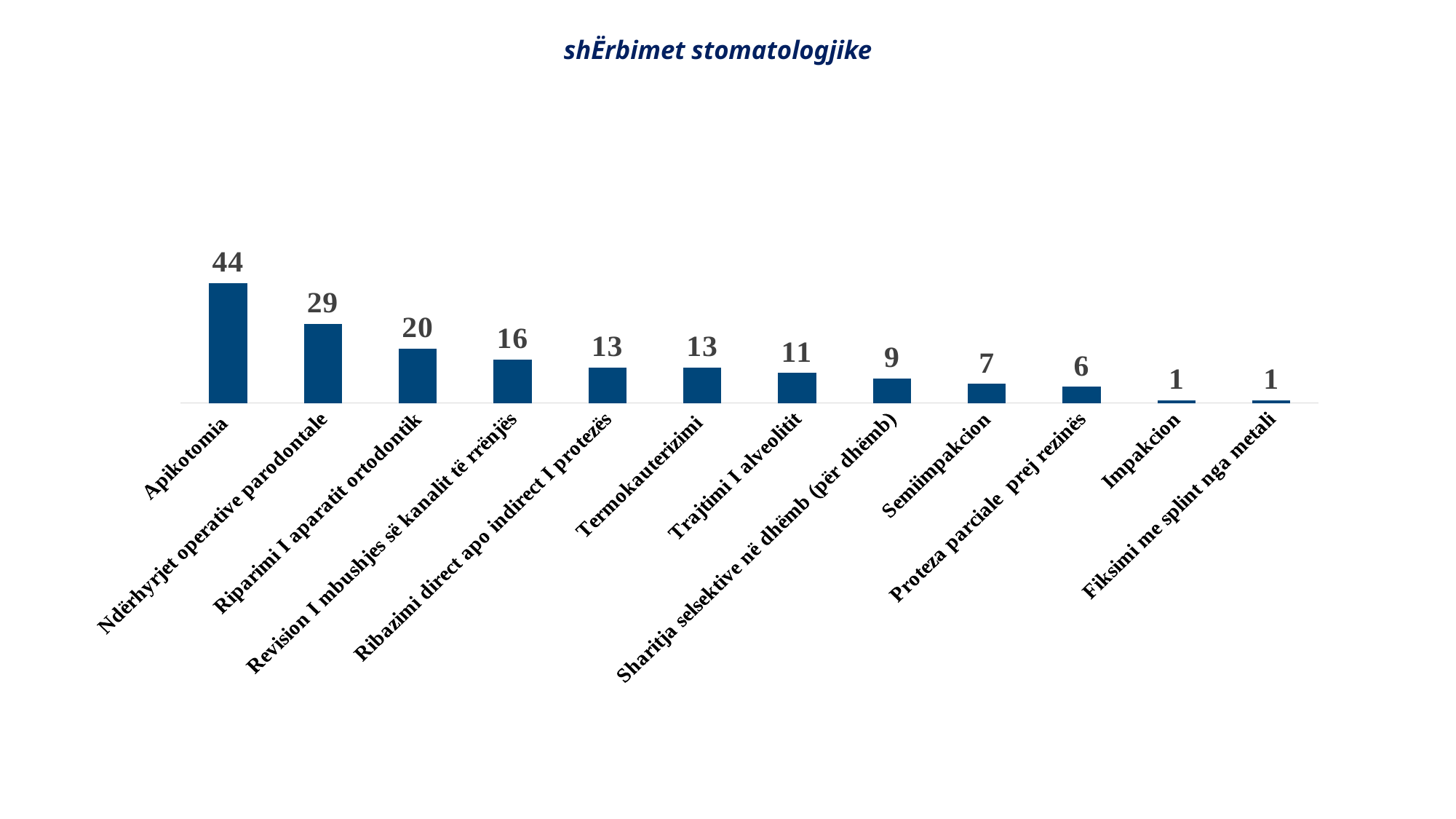
How many categories are shown in the chart? 12 Which is larger, Sharitja selsektive në dhëmb (për dhëmb) or Proteza parciale prej rezinës? Sharitja selsektive në dhëmb (për dhëmb) What is the value for Termokauterizimi? 13 What is the difference between Apikotomia and Ndërhyrjet operative parodontale? 15 Do the values rise or fall from left to right along the x axis? Fall What is the value for Semiimpakcion? 7 What is the value for Riparimi I aparatit ortodontik? 20 What is the difference between Revision I mbushjes së kanalit të rrënjës and Trajtimi I alveolitit? 5 What is the title of the chart? shËrbimet stomatologjike What is the value for Apikotomia? 44 Which category has the highest value? Apikotomia What kind of chart is this? Bar chart